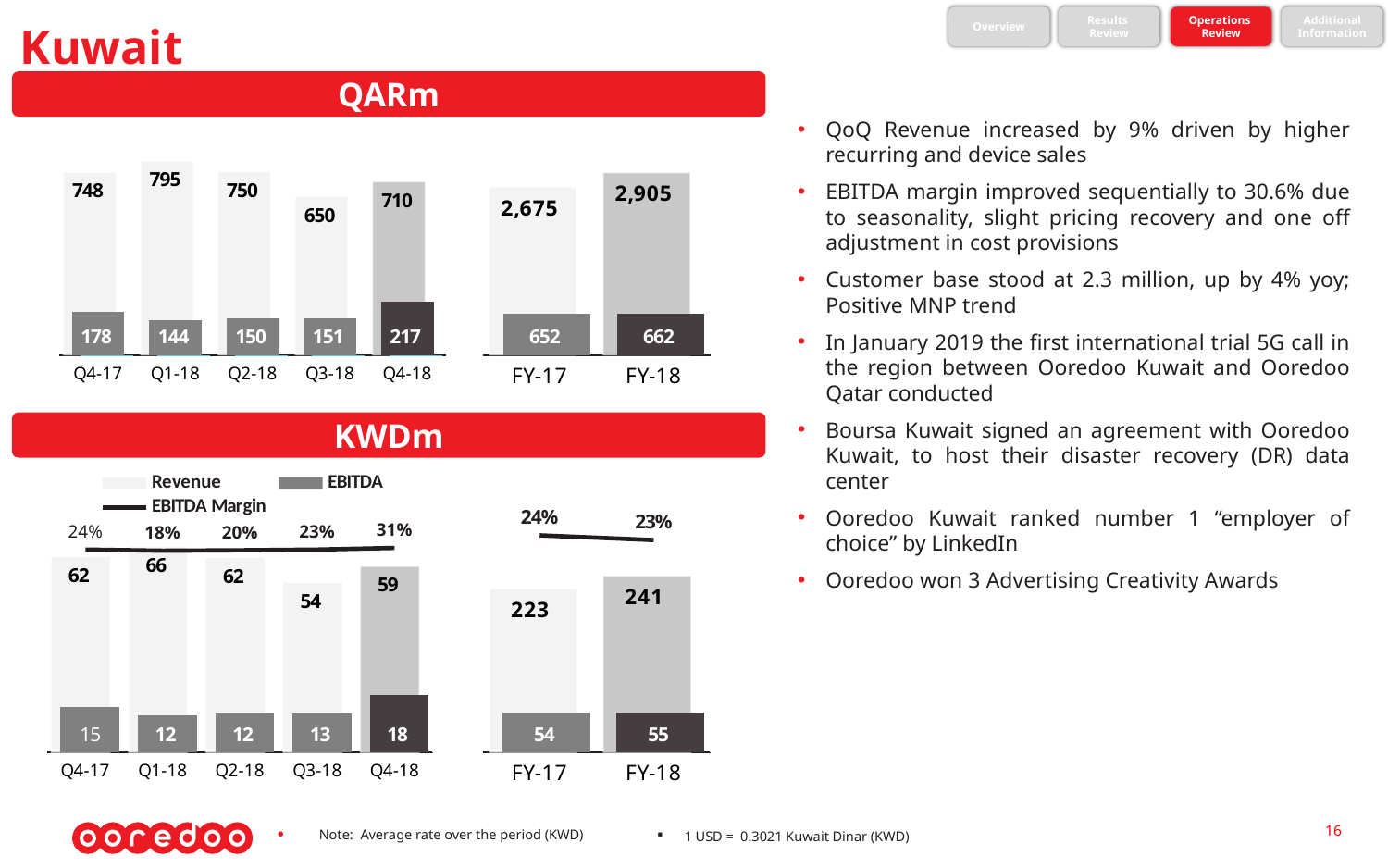
In the QARm chart, which quarter has the highest EBITDA? Q4-18 In the QARm chart, what is the difference between FY-18 and FY-17 revenue? 230 In the KWDm chart, what is the EBITDA margin for Q4-18? 31% In the QARm chart, what is the revenue for Q1-18? 795 In the KWDm chart, what is the revenue for FY-18? 241 In the QARm chart, which quarter has the lowest revenue? Q3-18 What kind of chart is the QARm chart? Bar chart In the KWDm chart, what is the difference between Q4-18 and Q3-18 EBITDA? 5 In the KWDm chart, is the revenue for Q1-18 larger than the revenue for Q3-18? Yes In the KWDm chart, which quarter has the lowest EBITDA margin? Q1-18 In the QARm chart, what is the EBITDA for Q4-18? 217 How many series does the legend of the KWDm chart list? 3